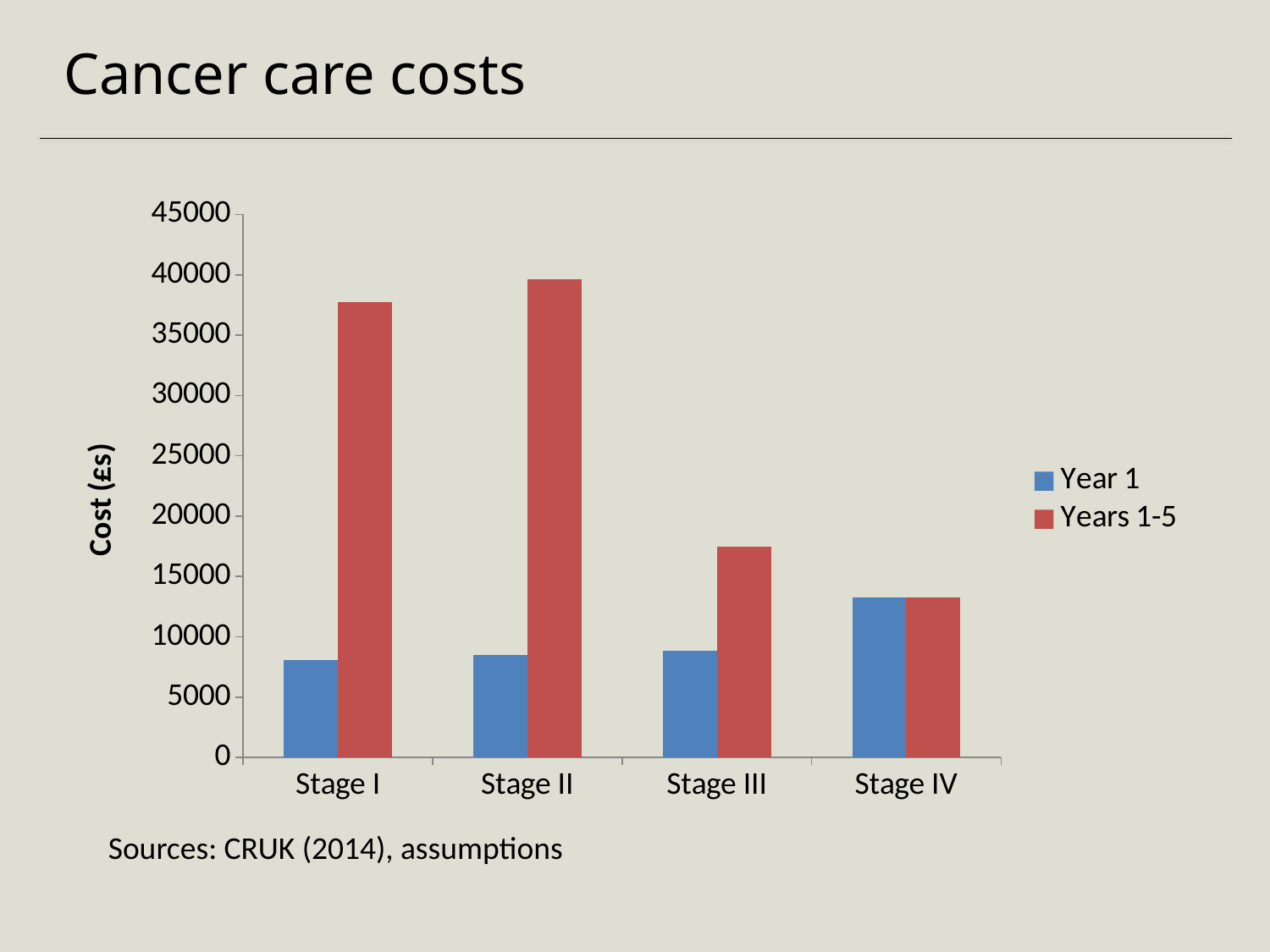
How many stages are shown on the x axis? 4 What kind of chart is shown on the slide? bar chart How many series does the legend list? 2 Which is larger, the Years 1-5 cost for Stage I or for Stage III? Stage I Which stage has the lowest Years 1-5 cost? Stage IV Is the Year 1 cost for Stage IV greater or less than 10000? greater Is the Years 1-5 cost for Stage III greater or less than 15000? greater Which stage has the highest Years 1-5 cost? Stage II Is the Year 1 cost for Stage I greater or less than 10000? less What is the label on the vertical axis? Cost (£s) Which stage has the highest Year 1 cost? Stage IV